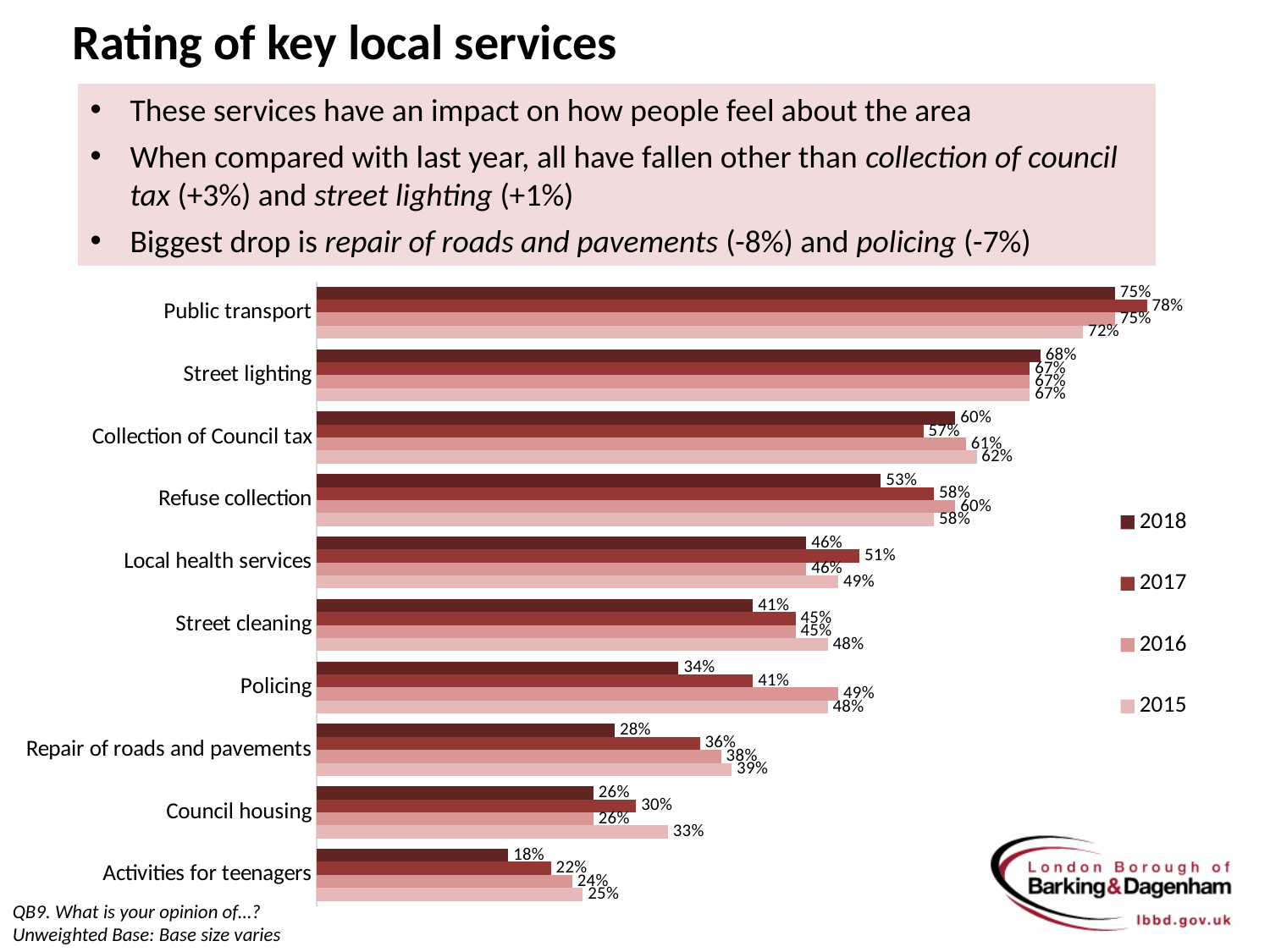
Which category has the lowest 2018 value? Activities for teenagers Which year does the darkest bar colour represent in the legend? 2018 Which category has the highest 2018 value? Public transport What is the 2018 value for Policing? 34% What is the 2017 value for Public transport? 78% Which is larger for Refuse collection: the 2018 value or the 2016 value? 2016 How many service categories are shown on the chart? 10 What type of chart is shown on the slide? bar chart What is the difference between the 2017 and 2018 values for Repair of roads and pavements? 8% What is the 2015 value for Council housing? 33% How many series does the legend list? 4 Do the values for Activities for teenagers rise or fall from 2015 to 2018? fall